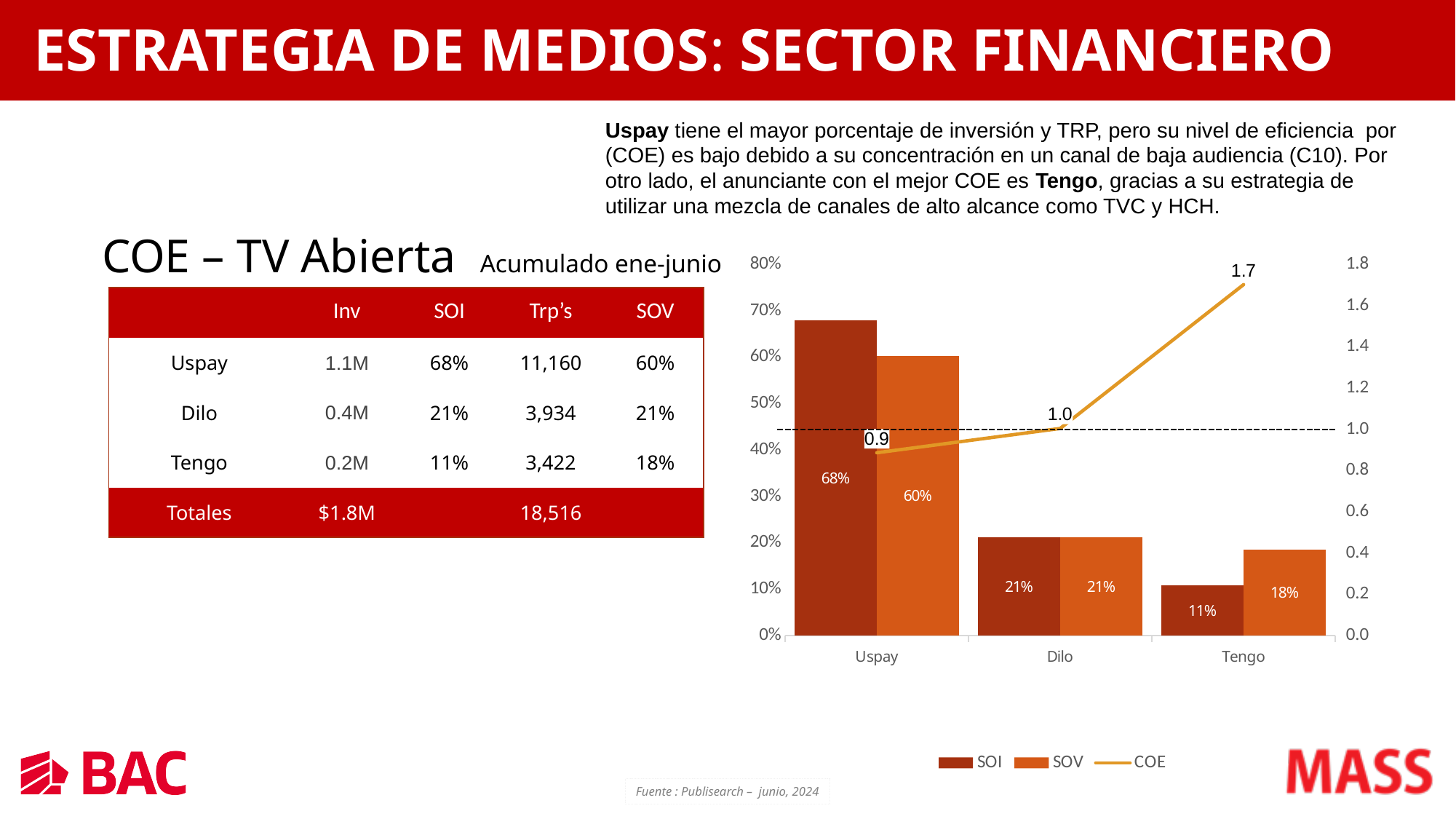
Does the COE line rise or fall from Uspay to Tengo? rises Which advertiser has the highest COE in the chart? Tengo How many series does the chart legend list? 3 What is the SOV value for Tengo in the chart? 18% Which advertiser has the lowest SOI in the chart? Tengo What is the difference between the COE values for Tengo and Uspay? 0.8 Which series in the chart is drawn as a line rather than bars? COE What is the difference between the SOI and SOV values for Uspay? 8% What is the COE value for Dilo in the chart? 1.0 How many advertisers are shown on the x axis of the chart? 3 Which is larger for Tengo, SOI or SOV? SOV What is the SOI value for Uspay in the chart? 68%